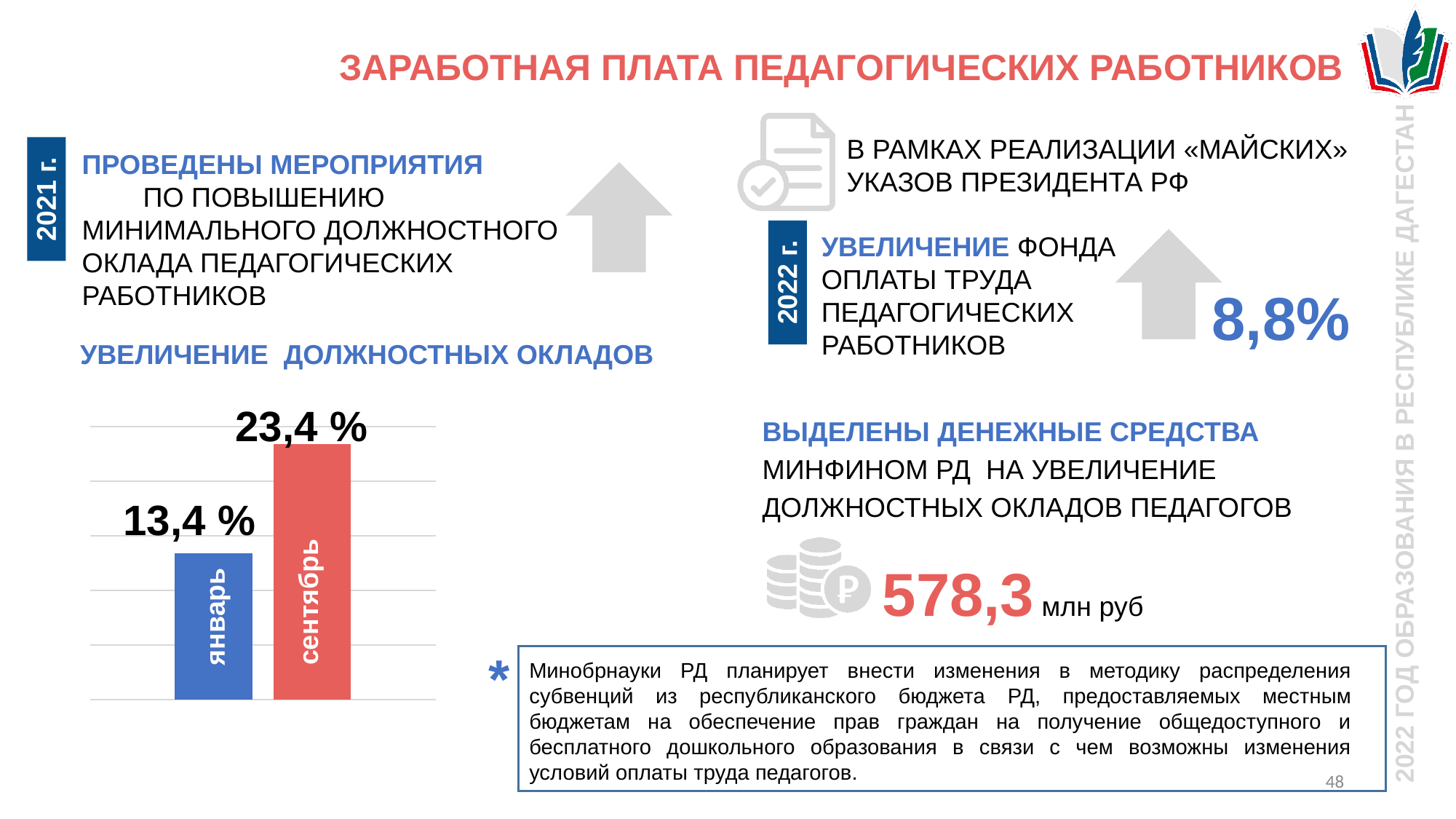
Do the values in the bar chart rise or fall from январь to сентябрь? rise What is the difference between the values for сентябрь and январь in the bar chart? 10,0 % What kind of chart is shown on the slide? bar chart What is the value shown for январь in the bar chart? 13,4 % Which is larger in the bar chart, the value for январь or the value for сентябрь? сентябрь What is the value shown for сентябрь in the bar chart? 23,4 % Which category has the highest value in the bar chart? сентябрь What colour is the bar for сентябрь in the chart? red What is the title of the bar chart? УВЕЛИЧЕНИЕ ДОЛЖНОСТНЫХ ОКЛАДОВ Which category has the lowest value in the bar chart? январь How many bars are plotted in the chart? 2